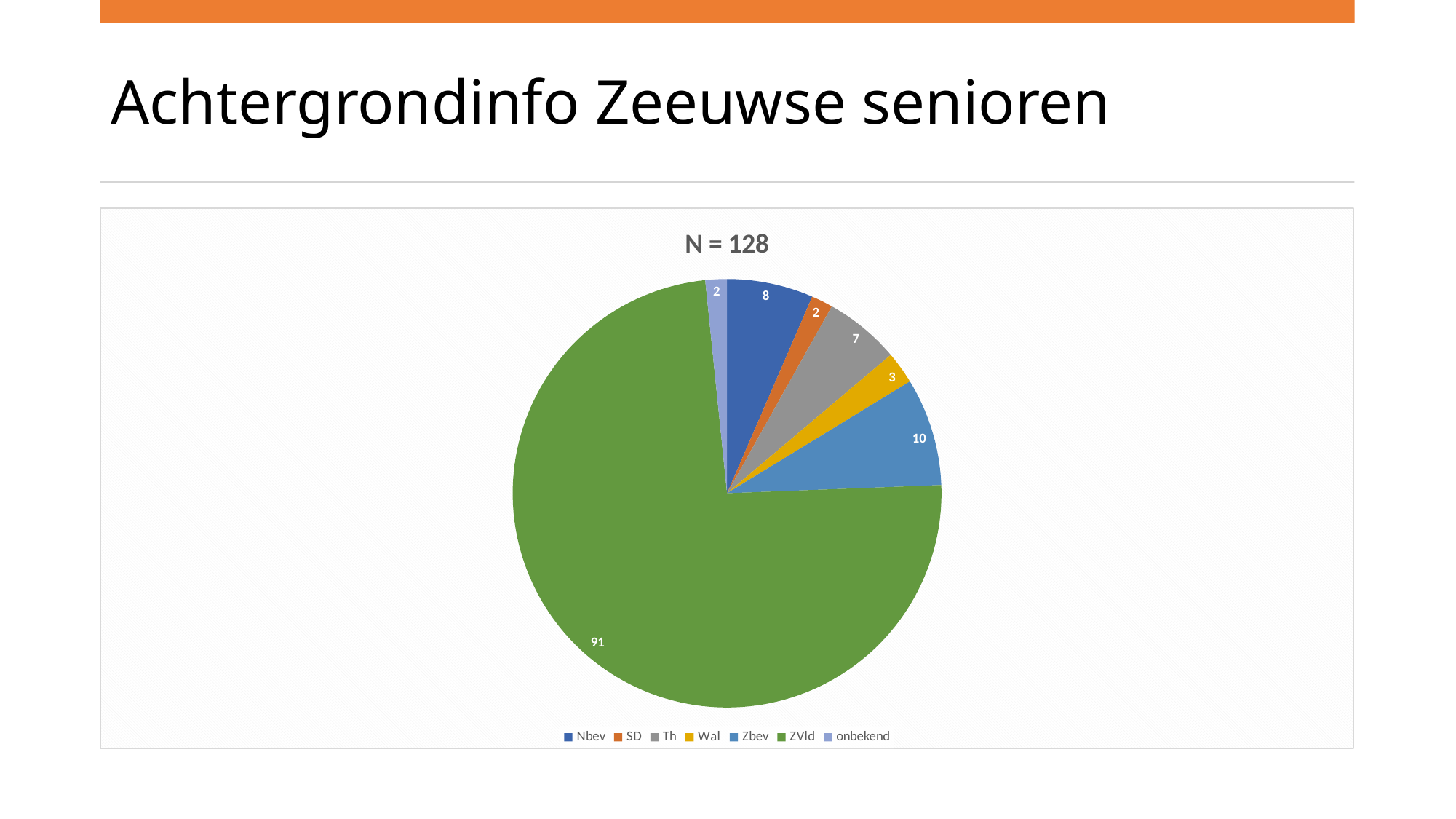
What is the value of the Th slice? 7 What is the value of the Wal slice? 3 Which category has the largest slice of the pie? ZVld What colour is the ZVld slice? green What kind of chart is shown on the slide? pie chart What is the title of the chart? N = 128 What is the difference between the ZVld value and the Zbev value? 81 What is the value of the Zbev slice? 10 What is the value of the Nbev slice? 8 What is the value of the ZVld slice? 91 How many categories does the legend of the pie chart list? 7 Which is larger, the Nbev slice or the Th slice? Nbev